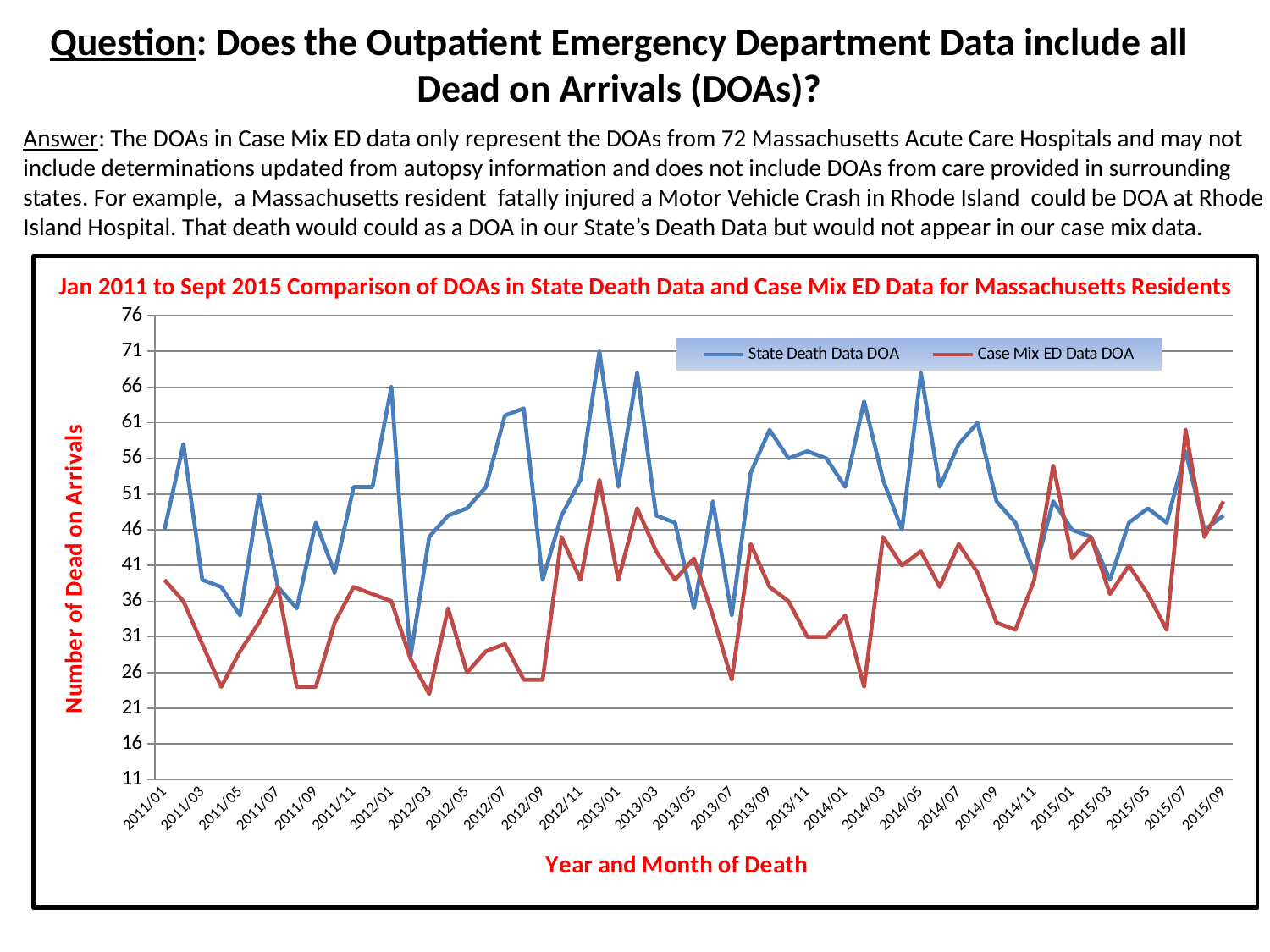
How many series does the chart's legend list? 2 What is the title of the chart's x axis? Year and Month of Death At 2014/03, which series has the higher value, State Death Data DOA or Case Mix ED Data DOA? State Death Data DOA Is the Case Mix ED Data DOA value for 2012/03 greater or less than 26? less What are the two series named in the chart's legend? State Death Data DOA and Case Mix ED Data DOA Which series reaches the highest value anywhere on the chart? State Death Data DOA Is the State Death Data DOA value for 2013/01 greater or less than 66? less Is the Case Mix ED Data DOA value for 2015/07 greater or less than 56? greater At 2012/01, which series has the higher value, State Death Data DOA or Case Mix ED Data DOA? State Death Data DOA What kind of chart is shown on the slide? line chart